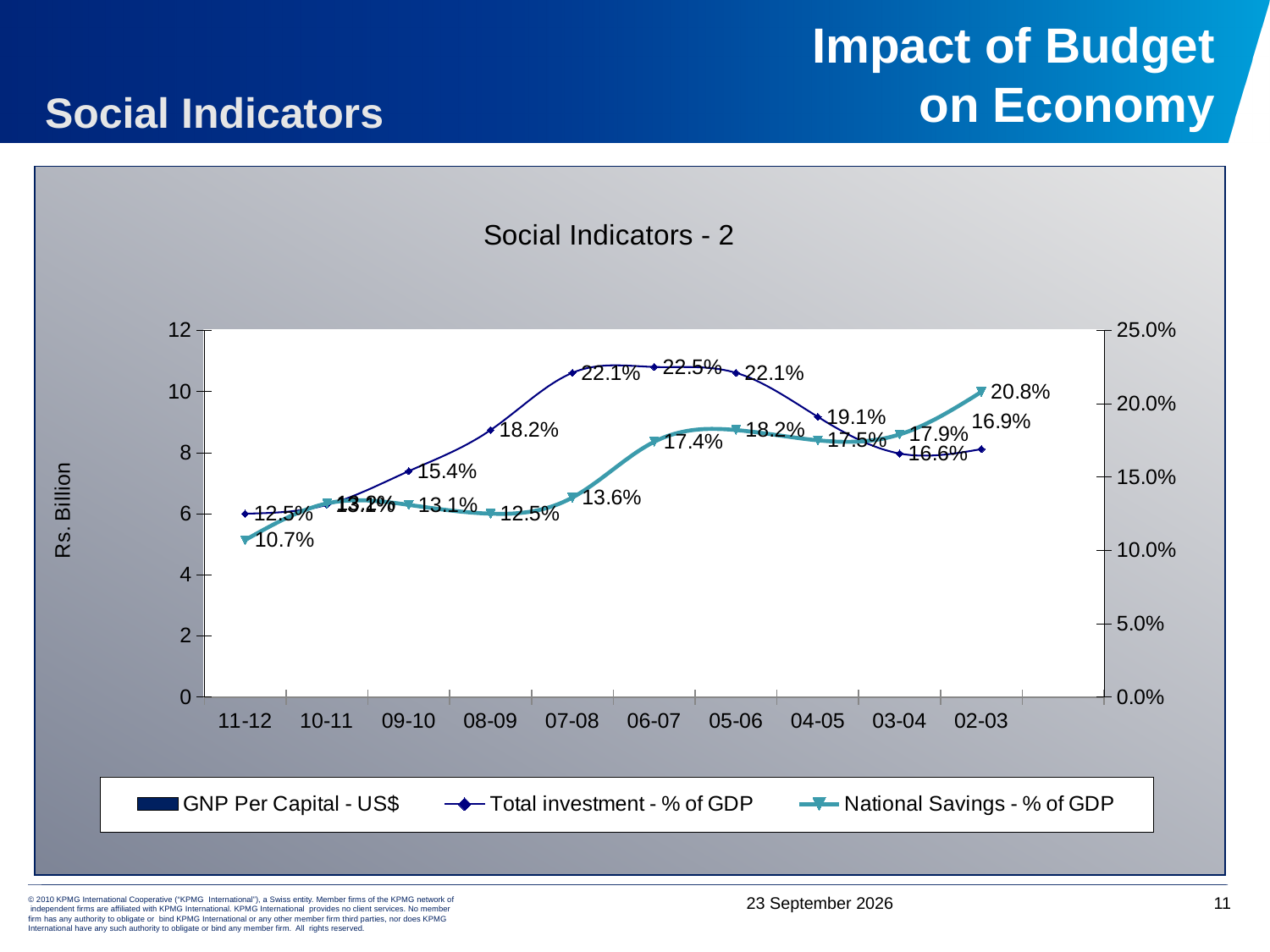
How many series does the legend list? 3 What kind of chart is used to plot the Total investment and National Savings series? Line chart How many year categories are shown on the x axis? 10 What is the Total investment - % of GDP value for 06-07? 22.5% What is the Total investment - % of GDP value for 08-09? 18.2% What is the title of the chart? Social Indicators - 2 In which year is National Savings - % of GDP lowest? 11-12 For 02-03, what is the difference between National Savings - % of GDP and Total investment - % of GDP? 3.9 percentage points What is the National Savings - % of GDP value for 11-12? 10.7% For 04-05, which is larger: Total investment - % of GDP or National Savings - % of GDP? Total investment - % of GDP What is the National Savings - % of GDP value for 02-03? 20.8% In which year is Total investment - % of GDP highest? 06-07